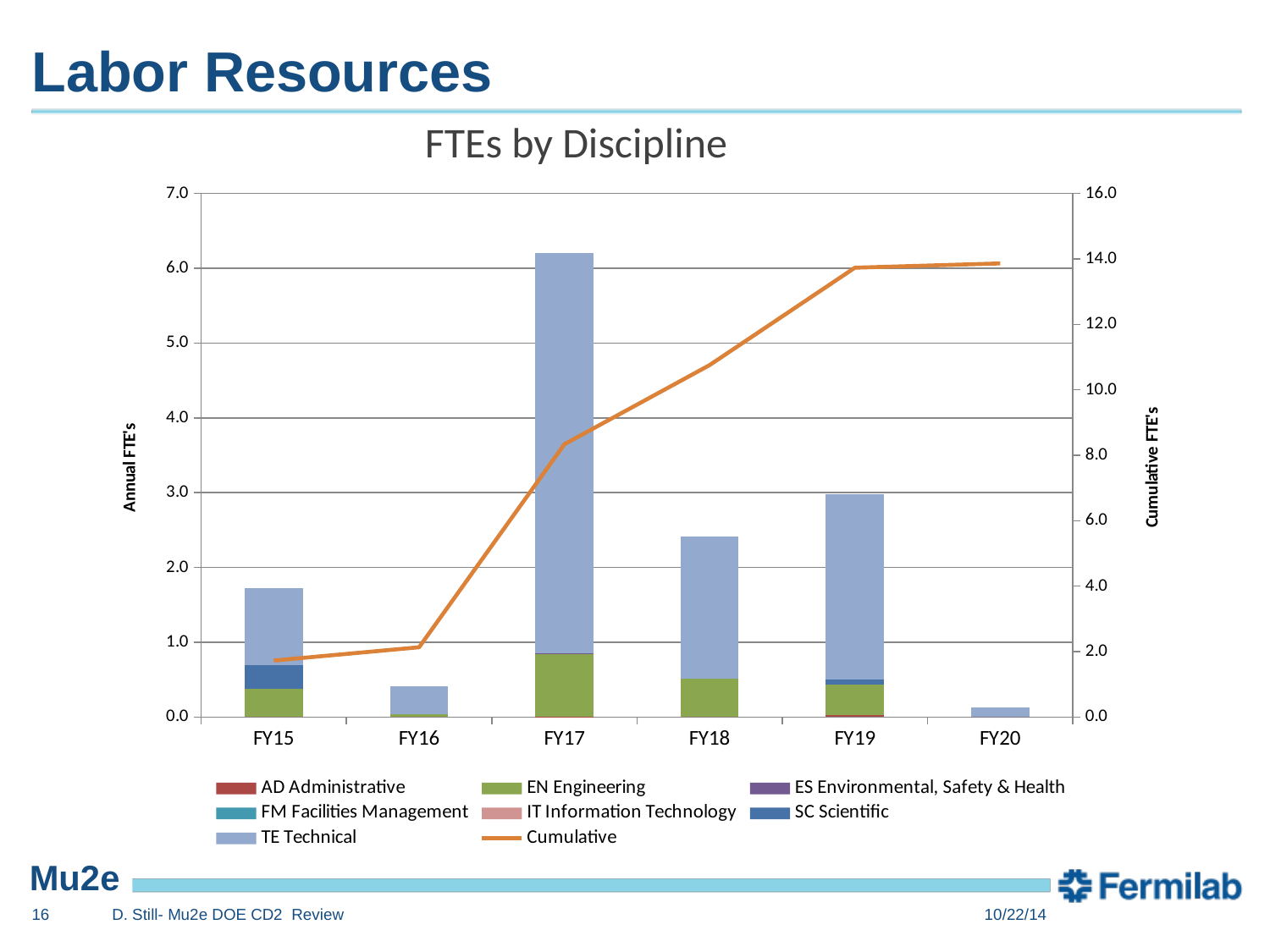
What is the title of the chart? FTEs by Discipline How many fiscal years are shown on the x axis? 6 Does the Cumulative line rise or fall from FY15 to FY20? rise Is the Cumulative value at FY20 greater or less than 12.0 on the right axis? greater Which fiscal year has the shortest stacked bar? FY20 How many series does the legend list? 8 Which is taller, the stacked bar for FY18 or the stacked bar for FY16? FY18 Is the total annual FTE value for FY16 greater or less than 1.0? less What kind of chart is used to show the FTEs by discipline? Stacked bar chart with a line Is the total annual FTE value for FY18 greater or less than 2.0? greater Which fiscal year has the tallest stacked bar? FY17